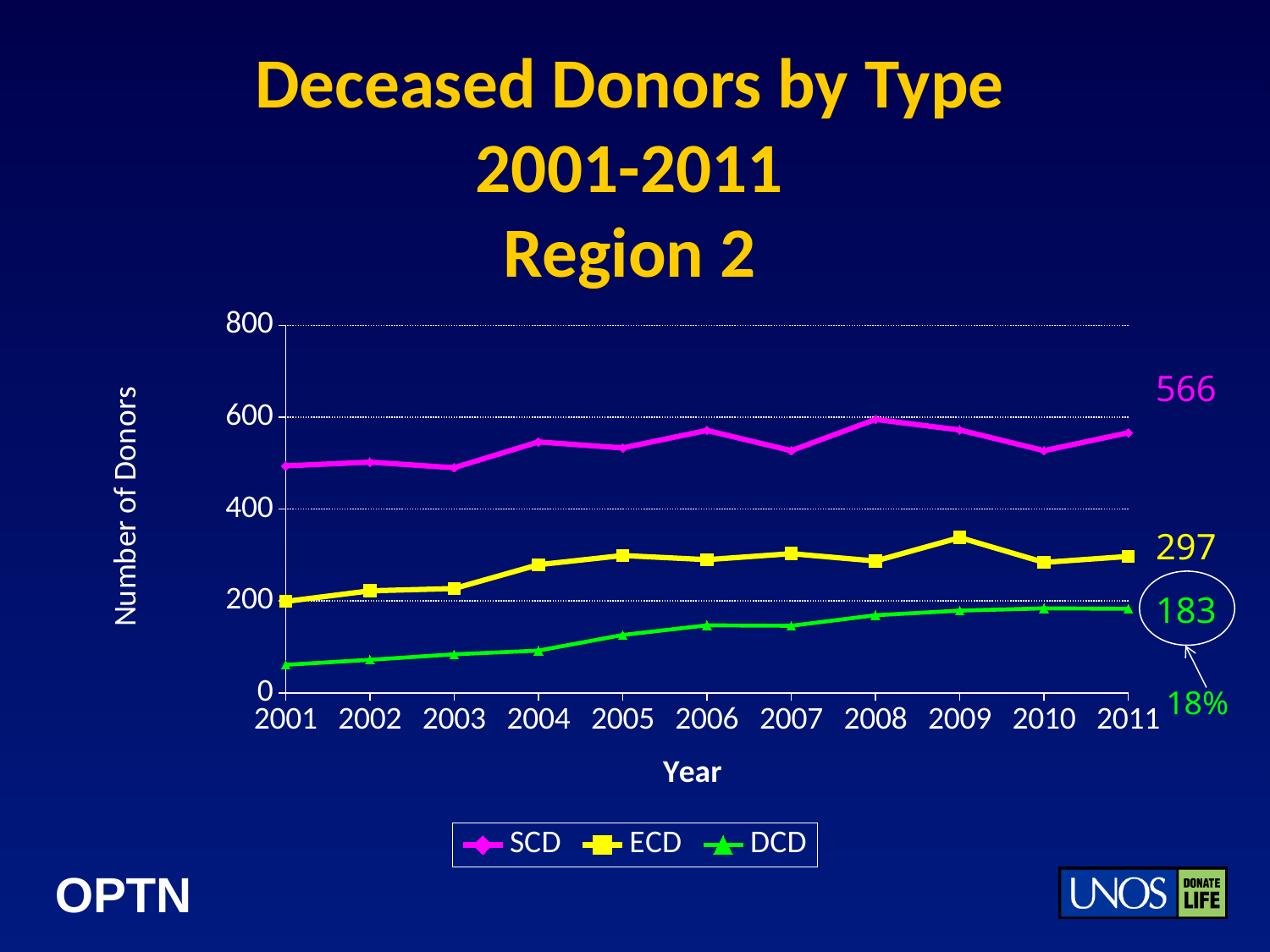
Does the DCD series generally rise or fall from 2001 to 2011? rise Is the value for DCD in 2001 greater or less than 200? less What is the difference between the SCD and ECD values in 2011? 269 What is the value for ECD in 2011? 297 Is the value for SCD in 2001 greater or less than 400? greater Which series has the highest value in 2011? SCD How many years are shown on the x axis? 11 How many series does the legend list? 3 What is the value for DCD in 2011? 183 What is the difference between the ECD and DCD values in 2011? 114 What is the value for SCD in 2011? 566 What kind of chart is shown on the slide? line chart